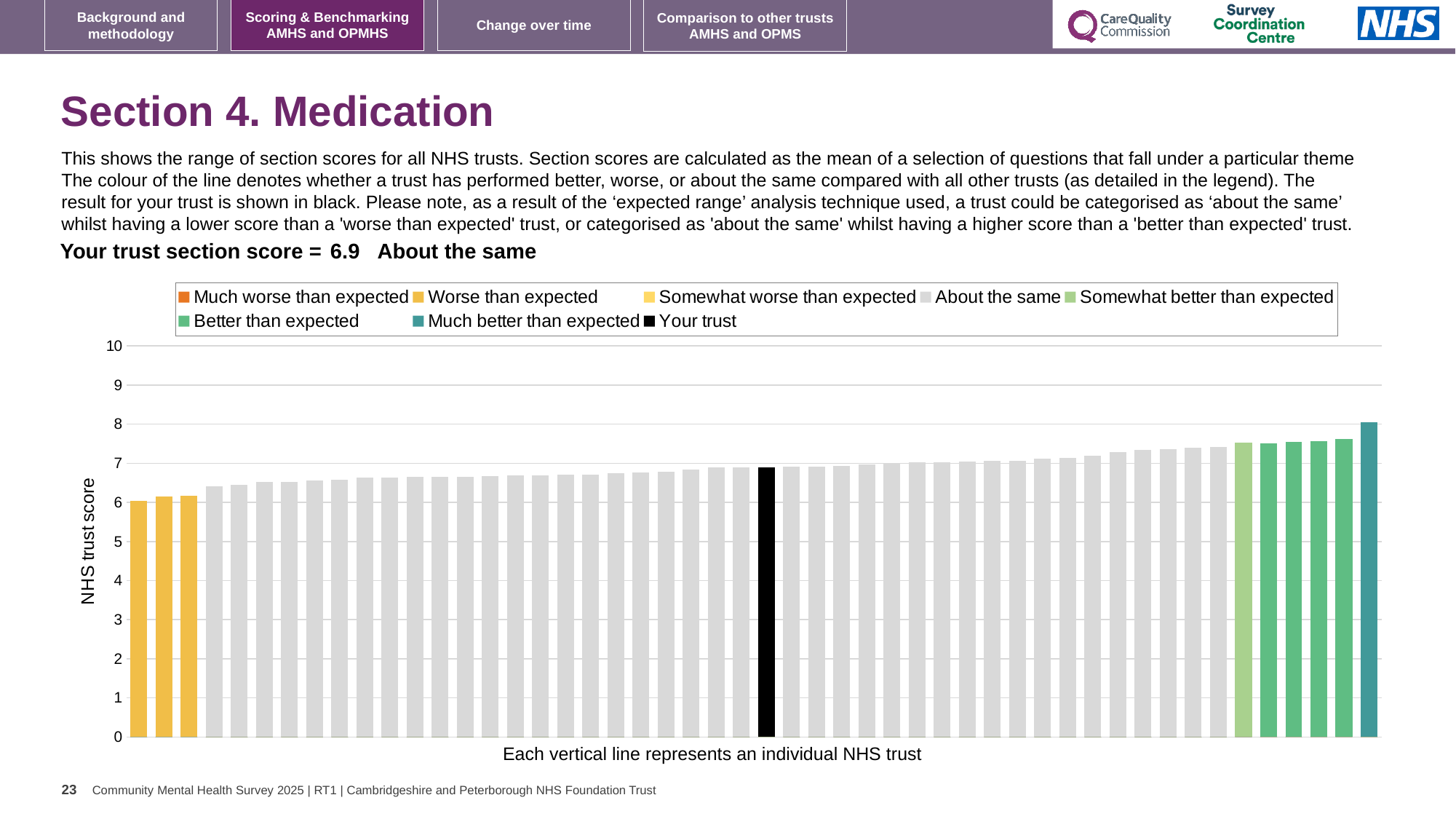
Is the value of the shortest bar greater or less than 7? less What is the section score for your trust shown on the slide? 6.9 How many entries does the chart legend list? 8 Is the value of the tallest bar greater or less than 7? greater How many bars are coloured as 'Worse than expected'? 3 Is the value of the shortest bar greater or less than 5? greater How many bars are coloured as 'Much better than expected'? 1 What is the label on the vertical axis of the chart? NHS trust score Do the bar values rise or fall from left to right along the x axis? rise What kind of chart is shown on the slide? bar chart Which category is your trust placed in for the Medication section? About the same